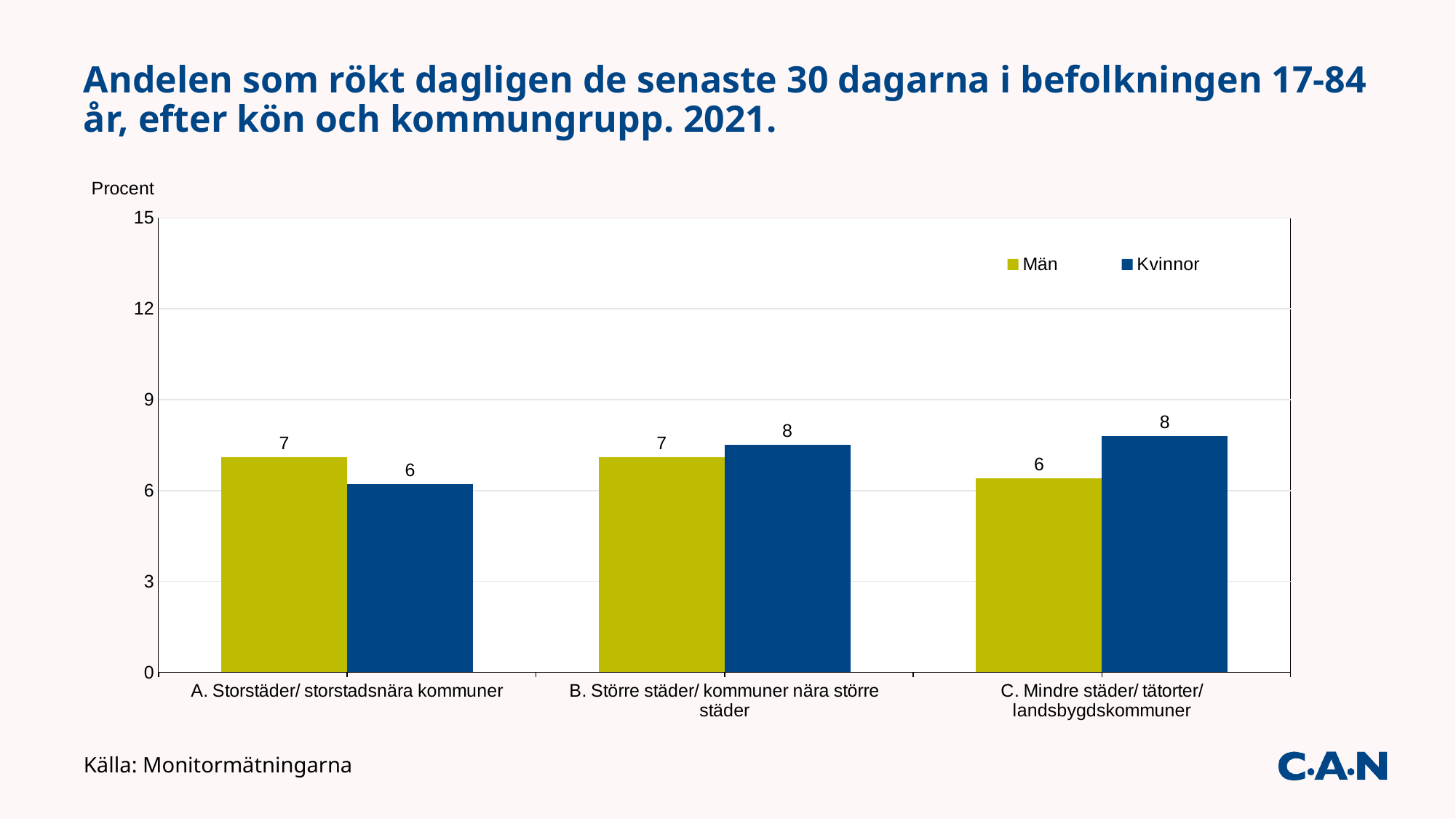
In which category is the Kvinnor value lowest? A. Storstäder/ storstadsnära kommuner What is the value for Kvinnor in category A. Storstäder/ storstadsnära kommuner? 6 Is the value for Kvinnor in category C. Mindre städer/ tätorter/ landsbygdskommuner greater or less than 9? less In category A. Storstäder/ storstadsnära kommuner, which is larger, Män or Kvinnor? Män In which category is the Män value lowest? C. Mindre städer/ tätorter/ landsbygdskommuner In category C. Mindre städer/ tätorter/ landsbygdskommuner, which is larger, Män or Kvinnor? Kvinnor How many series does the legend list? 2 What is the value for Män in category A. Storstäder/ storstadsnära kommuner? 7 What is the value for Kvinnor in category B. Större städer/ kommuner nära större städer? 8 What is the difference between the Män and Kvinnor values in category A. Storstäder/ storstadsnära kommuner? 1 What kind of chart is shown on the slide? bar chart What is the value for Män in category C. Mindre städer/ tätorter/ landsbygdskommuner? 6